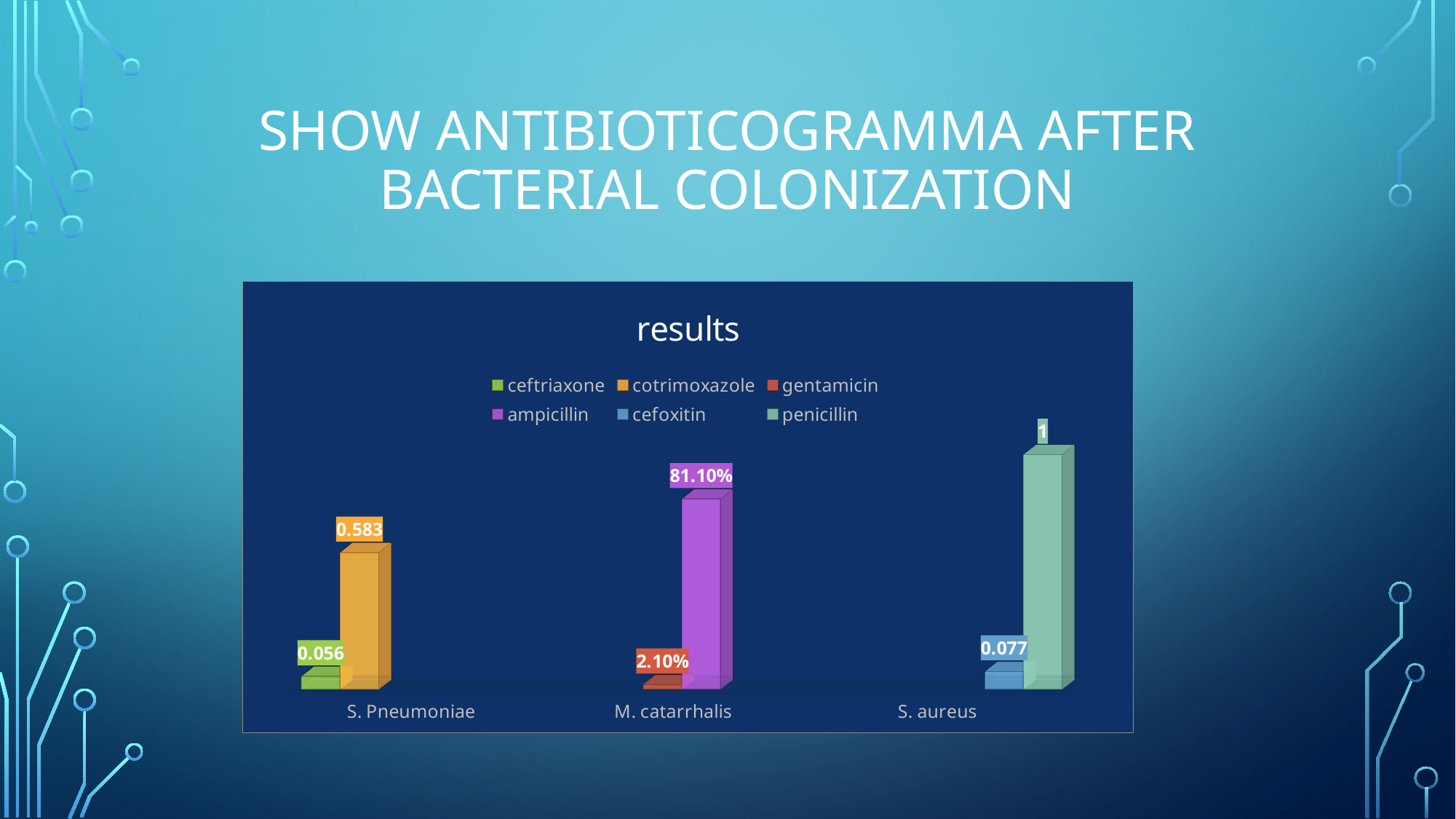
How many series does the legend list? 6 How many bacteria categories are shown on the x axis? 3 What kind of chart is shown on the slide? bar chart What is the difference between the cotrimoxazole and ceftriaxone values for S. Pneumoniae? 0.527 What is the value for cotrimoxazole for S. Pneumoniae? 0.583 Which bar is the tallest in the chart? penicillin for S. aureus For M. catarrhalis, which is larger: ampicillin or gentamicin? ampicillin What is the value for ampicillin for M. catarrhalis? 81.10% What is the value for penicillin for S. aureus? 1 For S. Pneumoniae, which series has the lower value? ceftriaxone What is the value for cefoxitin for S. aureus? 0.077 What is the value for gentamicin for M. catarrhalis? 2.10%